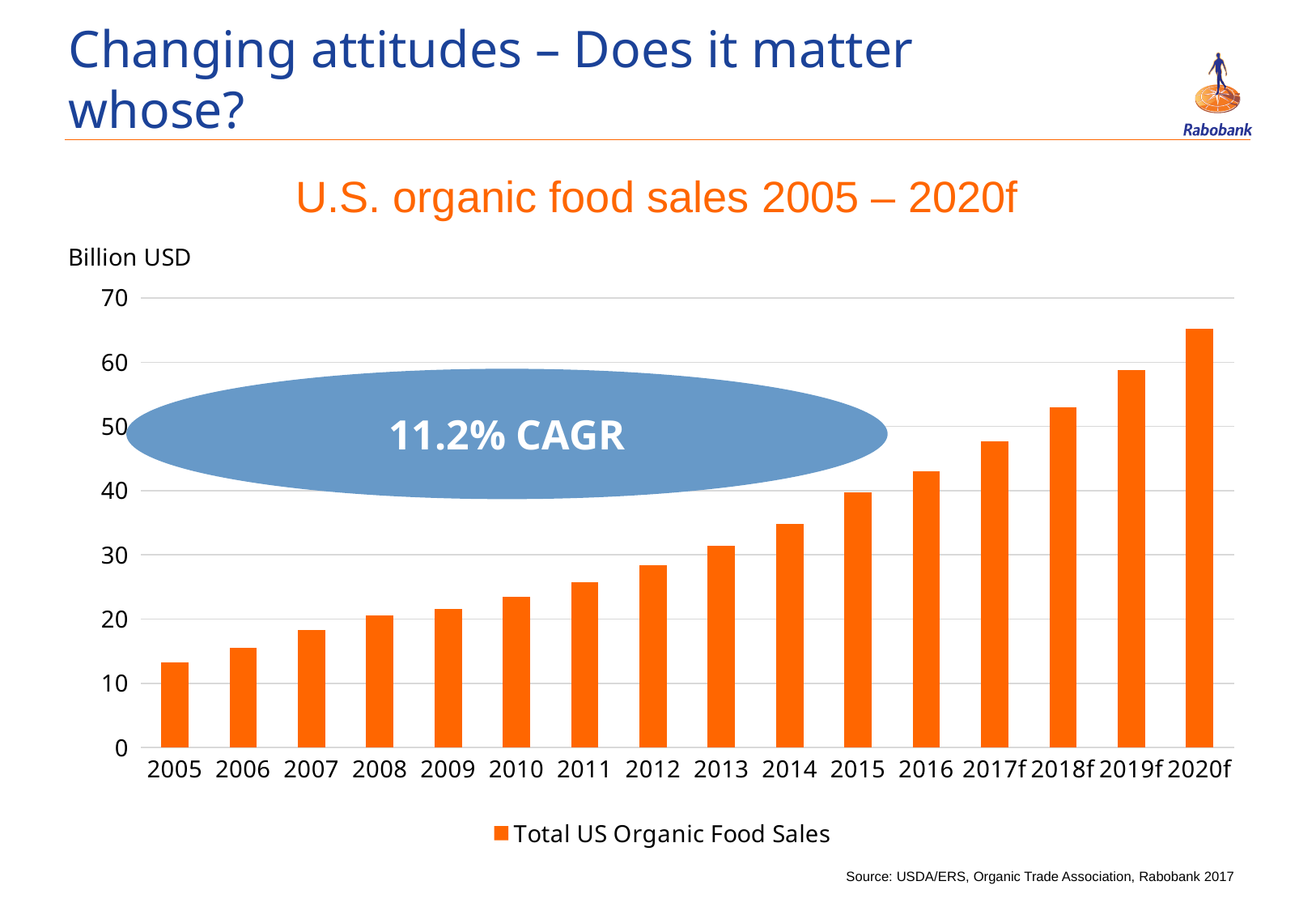
Is the value for 2018f greater or less than 50? greater Is the value for 2020f greater or less than 60? greater What CAGR is stated in the callout on the chart? 11.2% CAGR Which is larger, the value for 2014 or the value for 2011? 2014 Which year has the lowest value for Total US Organic Food Sales? 2005 Do the values rise or fall from 2005 to 2020f? Rise How many years are shown on the x axis of the chart? 16 What kind of chart is shown on the slide? Bar chart Is the value for 2013 greater or less than 30? greater Which year has the highest value for Total US Organic Food Sales? 2020f